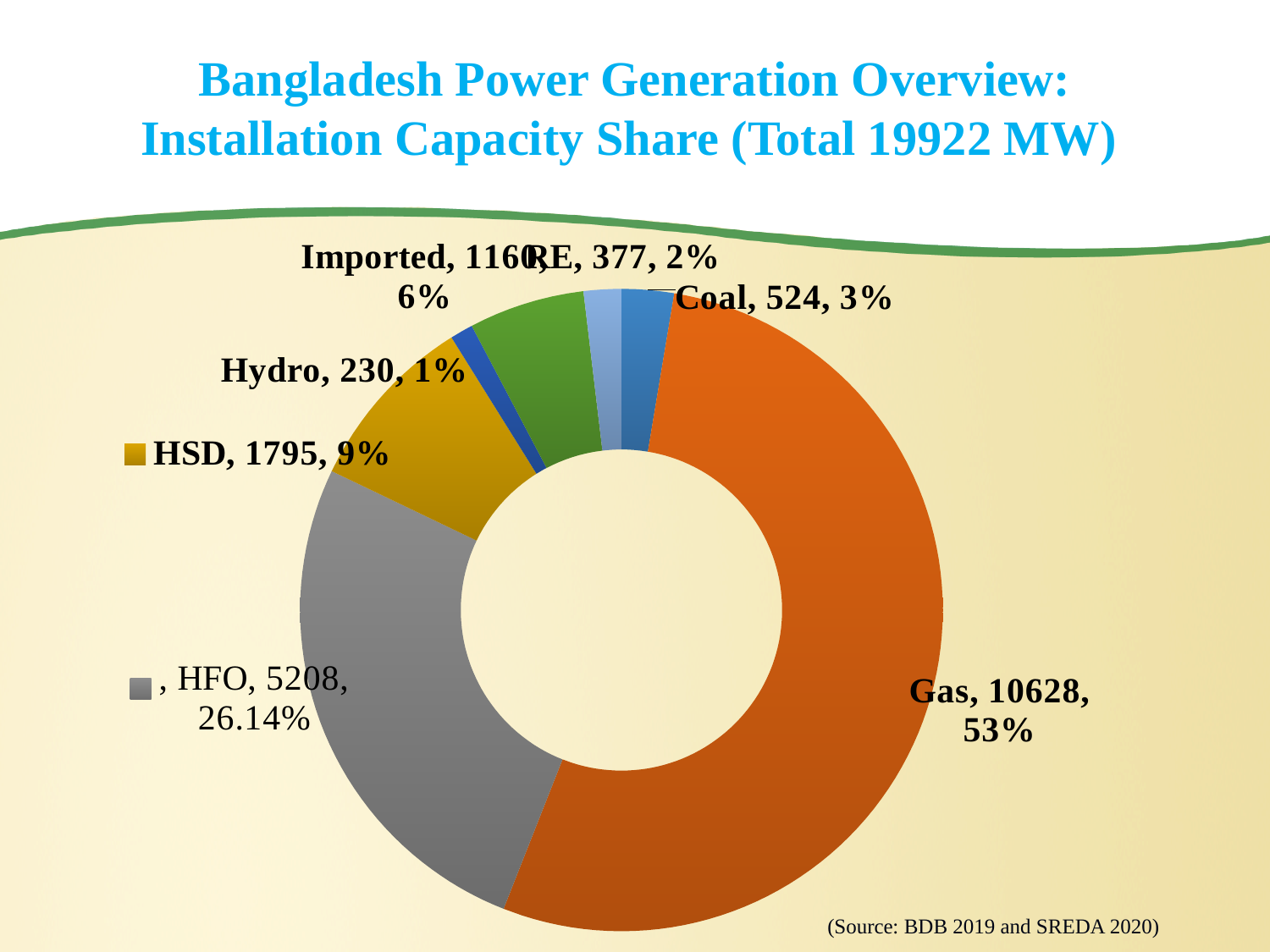
What kind of chart is shown on the slide? Doughnut (pie) chart Which category has the largest share of installation capacity? Gas What percentage share of installation capacity does Gas hold? 53% What is the installed capacity value shown for Coal? 524 Which category has the smallest share of installation capacity? Hydro Which is larger, the value for HSD or the value for Imported? HSD What percentage share of installation capacity does HFO hold? 26.14% How many categories are shown in the chart? 7 What is the installed capacity value shown for HFO? 5208 What is the installed capacity value shown for Gas? 10628 What is the installed capacity value shown for HSD? 1795 What is the difference between the Gas value and the HFO value? 5420